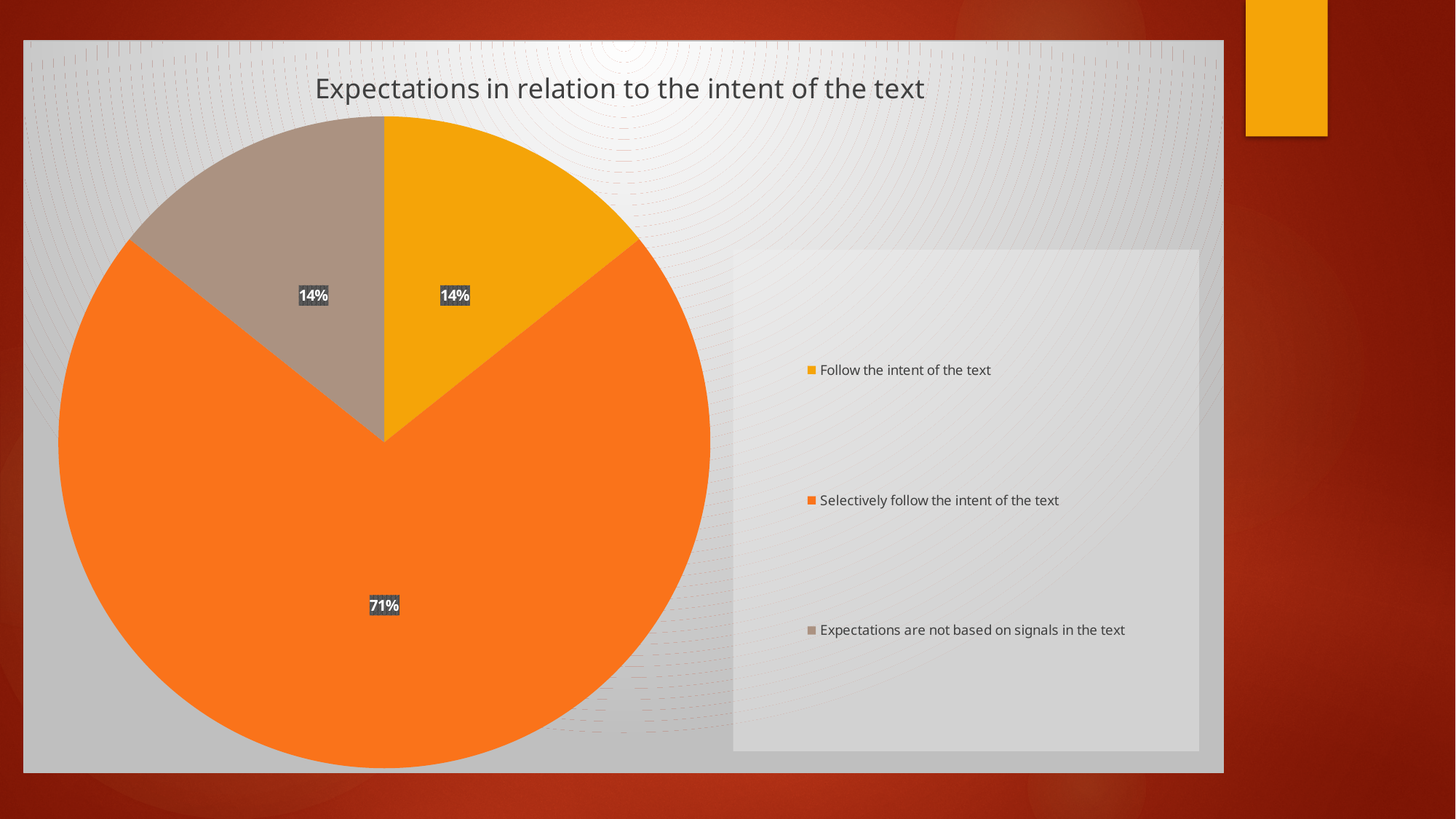
What share of the pie is 'Selectively follow the intent of the text'? 71% Which category has the largest slice of the pie? Selectively follow the intent of the text Which is larger: the slice for 'Selectively follow the intent of the text' or the slice for 'Expectations are not based on signals in the text'? Selectively follow the intent of the text How many slices does the pie chart have? 3 Is the share for 'Selectively follow the intent of the text' greater or less than 50%? greater What is the difference in percentage points between 'Selectively follow the intent of the text' and 'Follow the intent of the text'? 57 What kind of chart is shown on the slide? pie chart How many entries does the legend list? 3 Which colour represents 'Expectations are not based on signals in the text' in the legend? grey-brown What share of the pie is 'Expectations are not based on signals in the text'? 14% What is the title of the chart? Expectations in relation to the intent of the text What share of the pie is 'Follow the intent of the text'? 14%